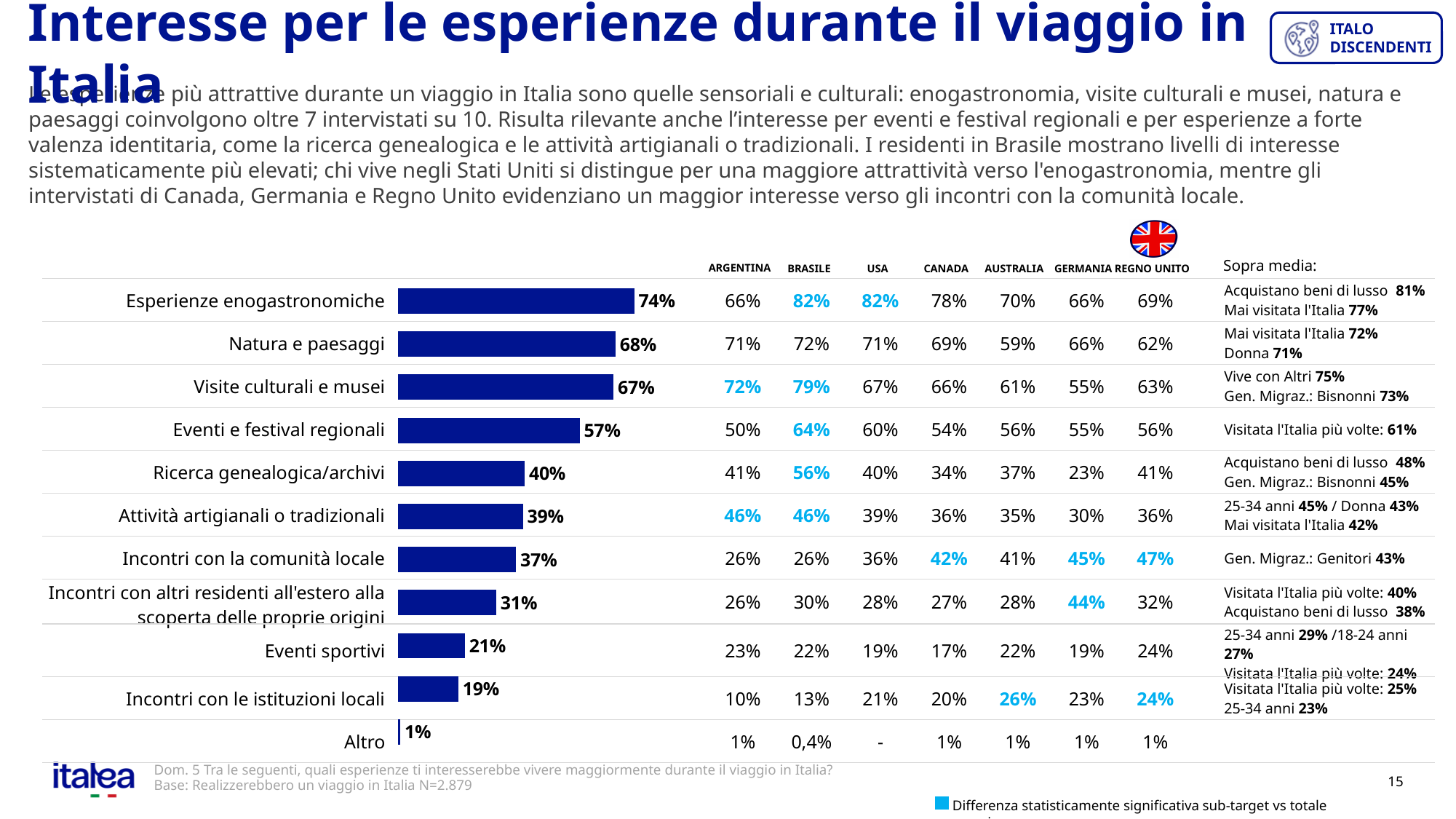
What is the difference between the values for "Esperienze enogastronomiche" and "Natura e paesaggi" in the bar chart? 6 percentage points Which category has the lowest value in the bar chart? Altro What is the value shown for "Ricerca genealogica/archivi" in the bar chart? 40% Which category has the highest value in the bar chart? Esperienze enogastronomiche What is the difference between the values for "Eventi e festival regionali" and "Eventi sportivi" in the bar chart? 36 percentage points What kind of chart is shown on the slide? Bar chart What is the value shown for "Attività artigianali o tradizionali" in the bar chart? 39% What is the value shown for "Incontri con le istituzioni locali" in the bar chart? 19% What is the value shown for "Esperienze enogastronomiche" in the bar chart? 74% Which has a larger value in the bar chart, "Eventi sportivi" or "Incontri con le istituzioni locali"? Eventi sportivi Do the bar values increase or decrease going from the top category to the bottom category? Decrease How many categories does the bar chart show? 11